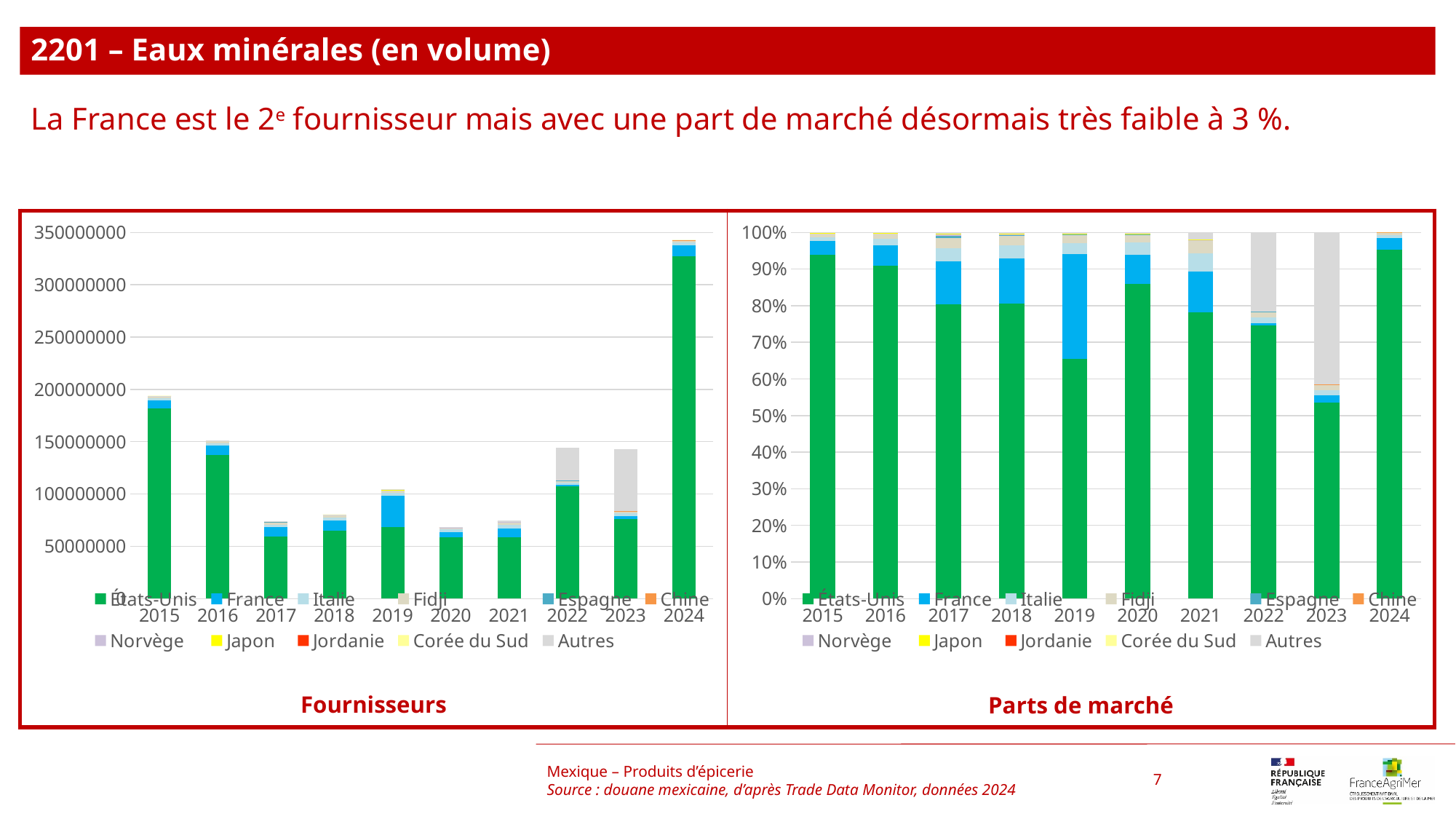
In the 'Parts de marché' chart, is the share of États-Unis larger in 2023 or in 2024? 2024 What kind of chart is the 'Fournisseurs' chart on the left? Stacked bar chart In the 'Fournisseurs' chart, is the total for 2024 greater or less than 300000000? greater In the 'Fournisseurs' chart, which year has the highest total volume? 2024 In the 'Fournisseurs' chart, is the total for 2015 greater or less than 200000000? less In the 'Parts de marché' chart, which year shows the largest share for Autres? 2023 How many series does the legend of the 'Parts de marché' chart list? 11 In the 'Parts de marché' chart, which year shows the largest share for France? 2019 In the 'Parts de marché' chart, is the share of États-Unis in 2024 greater or less than 90%? greater How many years are shown on the x axis of the 'Fournisseurs' chart? 10